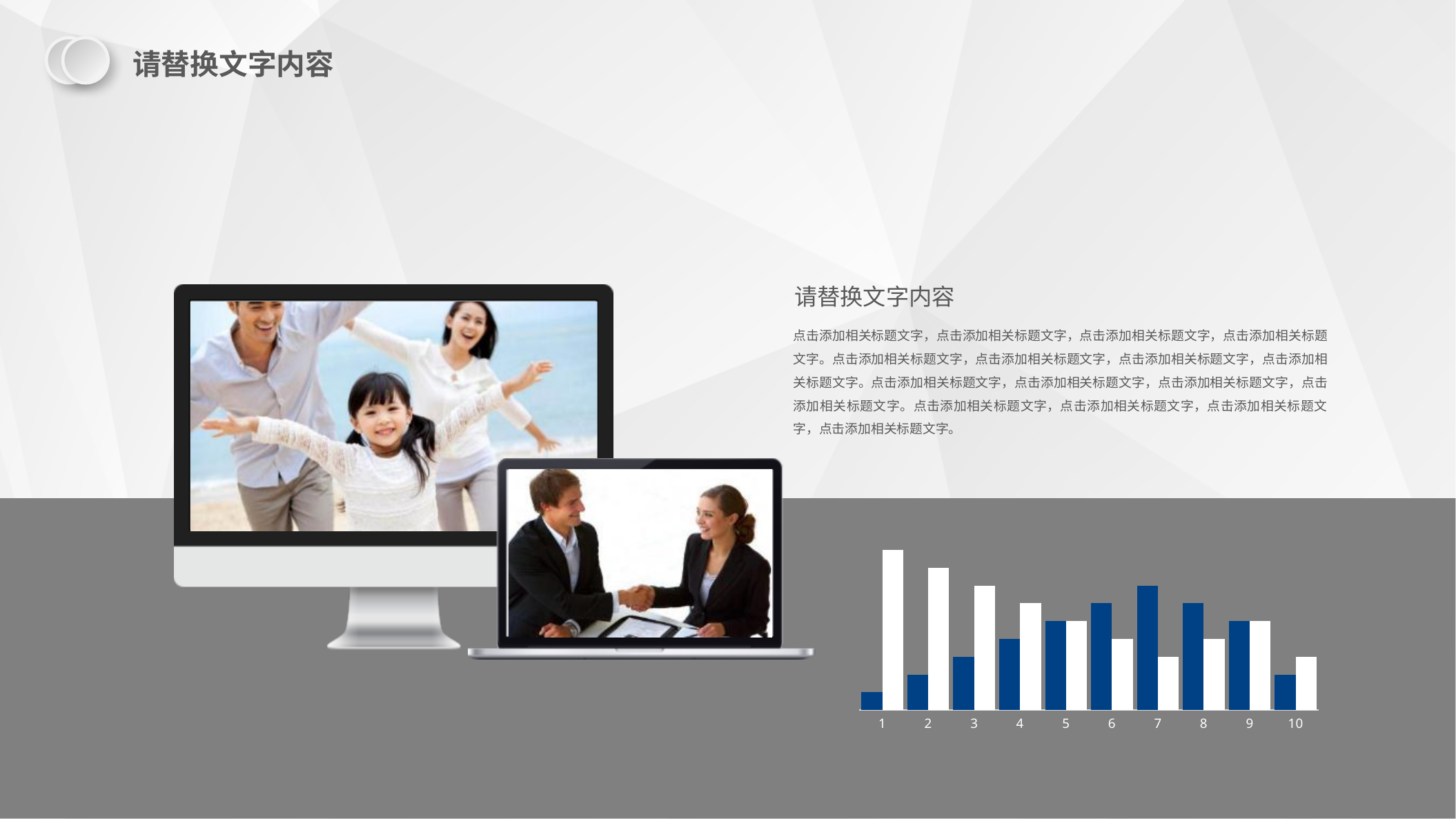
Do the white bars rise or fall from category 1 to category 4? fall What two colours are used for the bars in the chart? dark blue and white Which category has the tallest dark blue bar? 7 Do the dark blue bars rise or fall from category 1 to category 7? rise What kind of chart is shown at the bottom right of the slide? bar chart Which dark blue bar is taller, category 7 or category 10? category 7 Which category has the shortest dark blue bar? 1 Which white bar is taller, category 2 or category 4? category 2 How many categories are shown on the x axis of the bar chart? 10 At category 1, which bar is taller, the dark blue bar or the white bar? the white bar Which category has the tallest white bar? 1